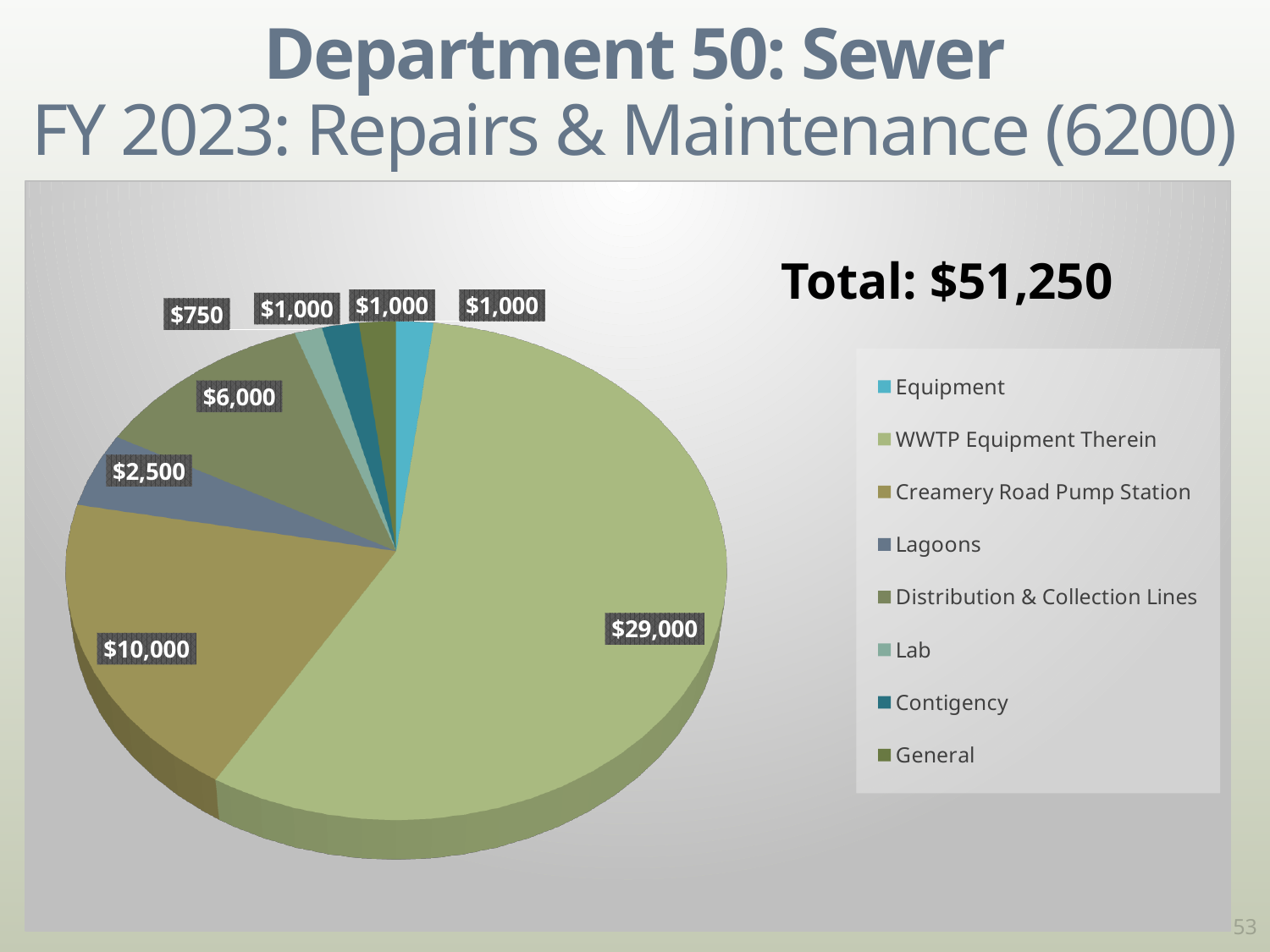
What is the value for Lagoons? $2,500 What is the difference between the values for WWTP Equipment Therein and Creamery Road Pump Station? $19,000 What is the value for Creamery Road Pump Station? $10,000 Which category has the smallest slice of the pie? Lab How many categories does the legend list? 8 Which category has the largest slice of the pie? WWTP Equipment Therein What kind of chart is shown on the slide? Pie chart What is the value for Distribution & Collection Lines? $6,000 Which is larger, Lagoons or Distribution & Collection Lines? Distribution & Collection Lines What is the value for WWTP Equipment Therein? $29,000 What total amount is stated next to the chart? $51,250 What is the value for Lab? $750